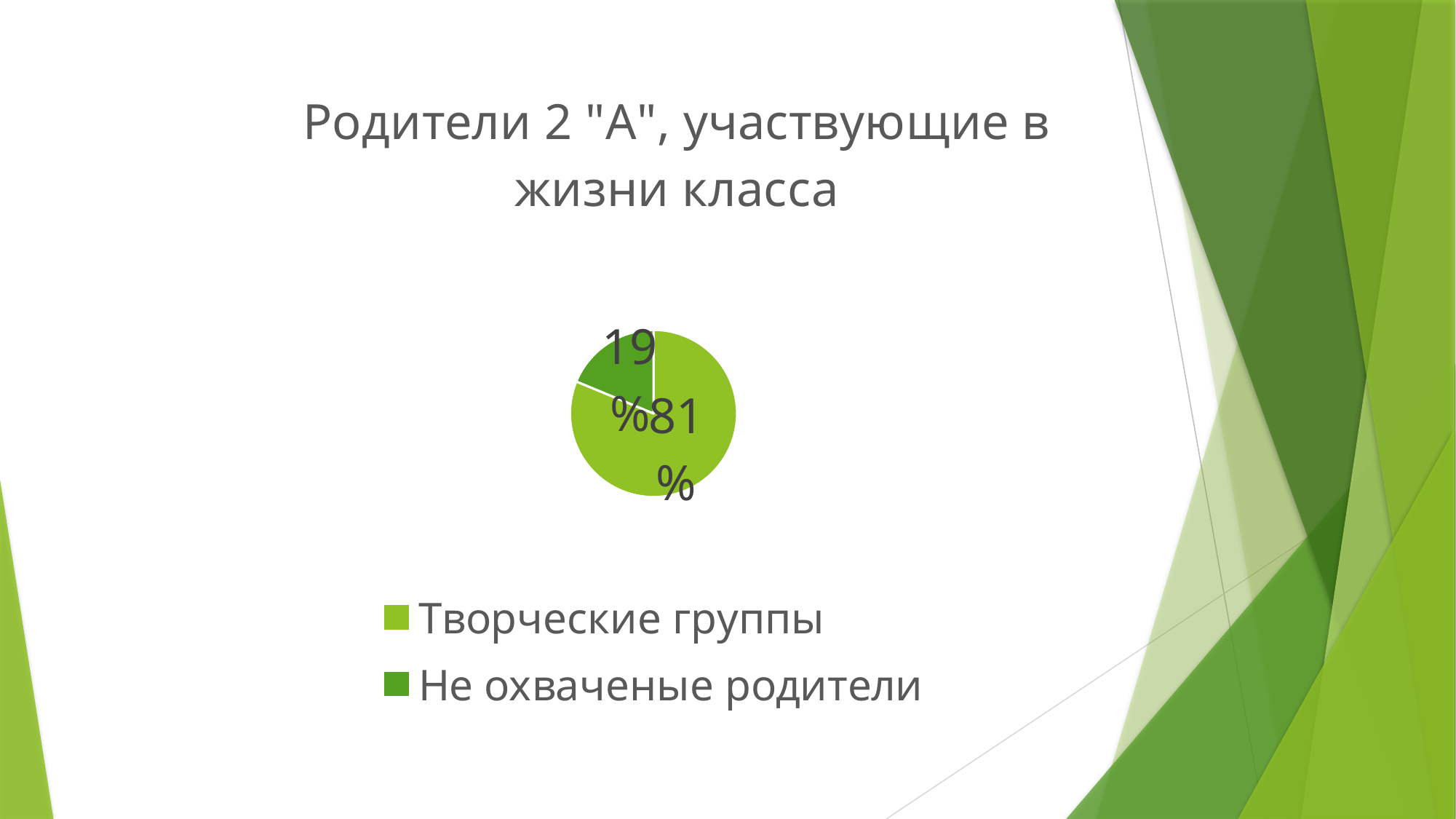
What is the title of the slide containing the pie chart? Родители 2 "А", участвующие в жизни класса Which slice is larger: "Творческие группы" or "Не охваченые родители"? Творческие группы What is the total of the two slice percentages shown on the pie chart? 100% Which category has the smallest slice of the pie? Не охваченые родители What share of the pie is labelled "Не охваченые родители"? 19% What share of the pie is labelled "Творческие группы"? 81% What is the difference in percentage points between the "Творческие группы" slice and the "Не охваченые родители" slice? 62 How many slices does the pie chart have? 2 What kind of chart is shown on the slide? pie chart Which category has the largest slice of the pie? Творческие группы How many entries does the legend list? 2 Which legend entry is shown in the darker green colour? Не охваченые родители